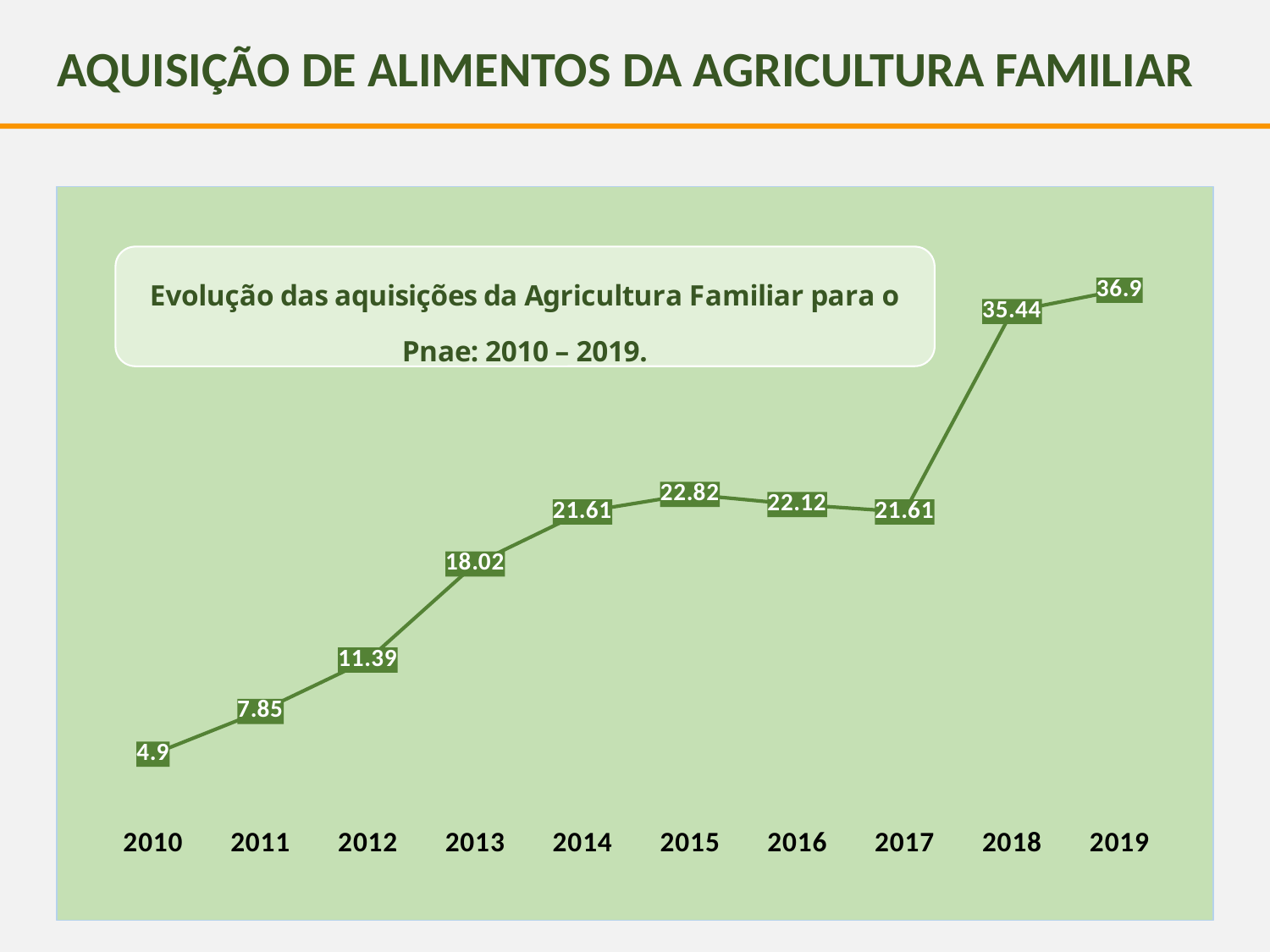
Which year has the lowest value? 2010 What is the value for 2010? 4.9 What is the value for 2018? 35.44 What is the difference between the values for 2019 and 2018? 1.46 How many years are plotted on the chart? 10 What kind of chart is shown? line chart Which year has the highest value? 2019 Which is larger, the value for 2015 or the value for 2016? 2015 What is the difference between the values for 2013 and 2012? 6.63 Do the values generally rise or fall from 2010 to 2019? rise What is the title of the chart? Evolução das aquisições da Agricultura Familiar para o Pnae: 2010 – 2019. What is the value for 2015? 22.82